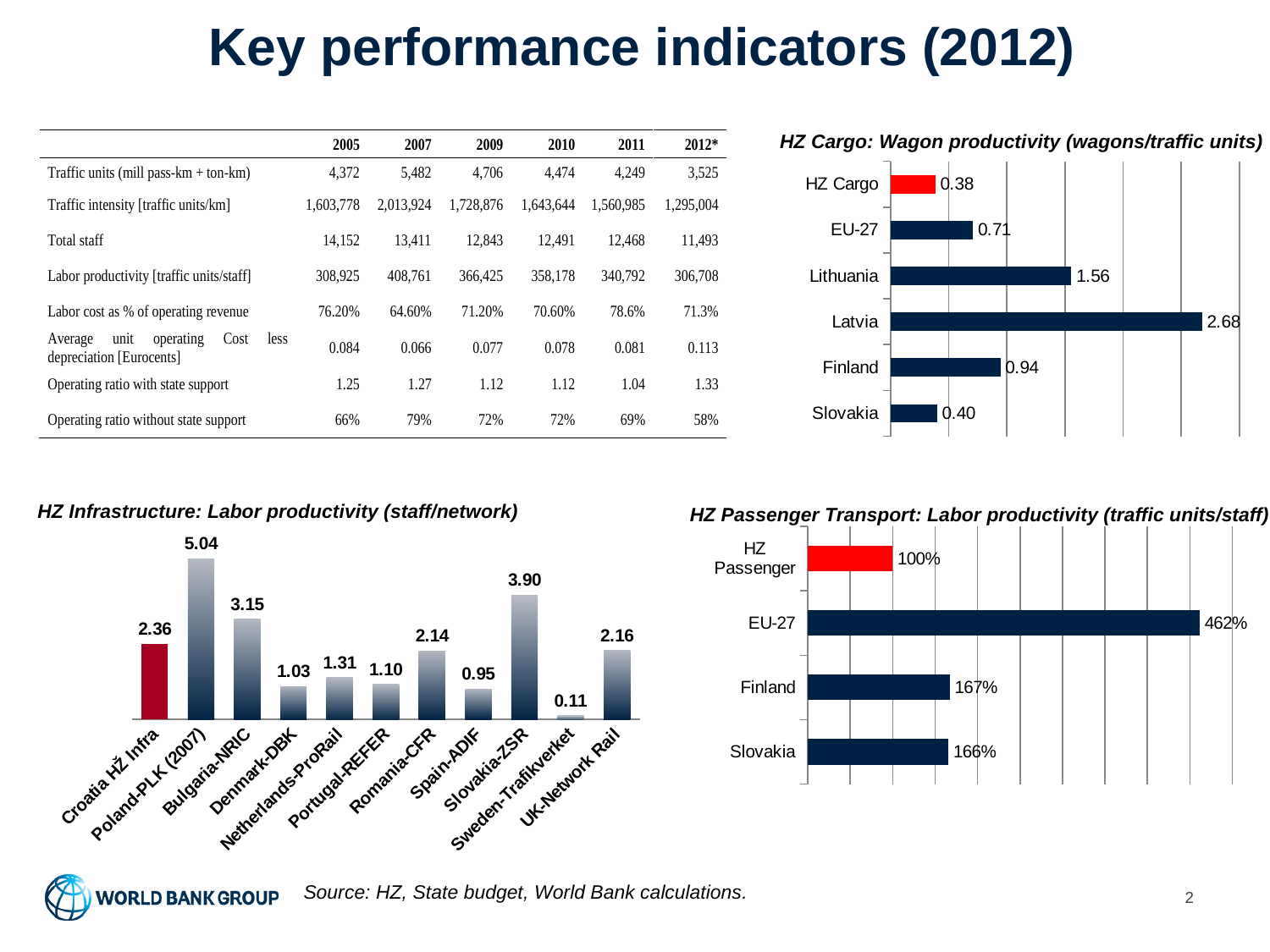
In the HZ Infrastructure: Labor productivity chart, which category has the highest value? Poland-PLK (2007) In the HZ Cargo: Wagon productivity chart, what is the value for Latvia? 2.68 How many categories are shown in the HZ Cargo: Wagon productivity chart? 6 In the HZ Passenger Transport: Labor productivity chart, what is the value for EU-27? 462% In the HZ Infrastructure: Labor productivity chart, which is larger, Bulgaria-NRIC or Romania-CFR? Bulgaria-NRIC How many categories are shown in the HZ Infrastructure: Labor productivity chart? 11 What kind of chart is the HZ Passenger Transport: Labor productivity chart? bar chart In the HZ Cargo: Wagon productivity chart, what is the difference between Lithuania and EU-27? 0.85 In the HZ Infrastructure: Labor productivity chart, which category has the lowest value? Sweden-Trafikverket In the HZ Infrastructure: Labor productivity chart, what is the value for Slovakia-ZSR? 3.90 In the HZ Passenger Transport: Labor productivity chart, what is the difference between Finland and HZ Passenger? 67% In the HZ Cargo: Wagon productivity chart, which category has the lowest value? HZ Cargo